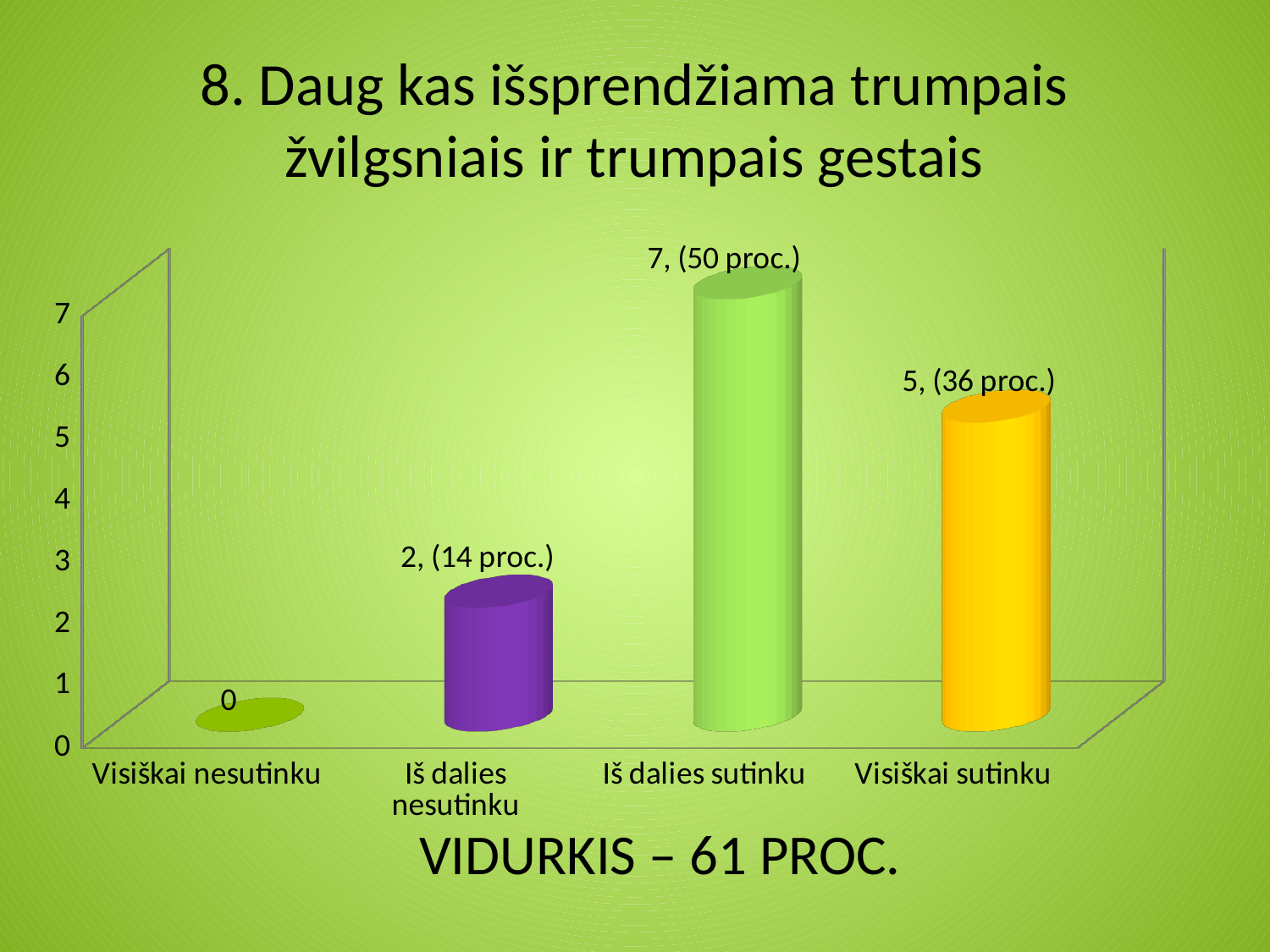
What average percentage is stated below the chart? 61 PROC. What is the value for "Visiškai nesutinku"? 0 What is the value for "Visiškai sutinku"? 5, (36 proc.) Which category has the highest value? Iš dalies sutinku What is the value for "Iš dalies nesutinku"? 2, (14 proc.) What kind of chart is shown on the slide? bar chart What is the difference in count between "Iš dalies sutinku" and "Visiškai sutinku"? 2 Is the value for "Visiškai sutinku" greater or less than 4? greater How many categories are shown on the x axis? 4 Which is larger, the value for "Iš dalies nesutinku" or the value for "Visiškai sutinku"? Visiškai sutinku What is the value for "Iš dalies sutinku"? 7, (50 proc.) Which category has the lowest value? Visiškai nesutinku